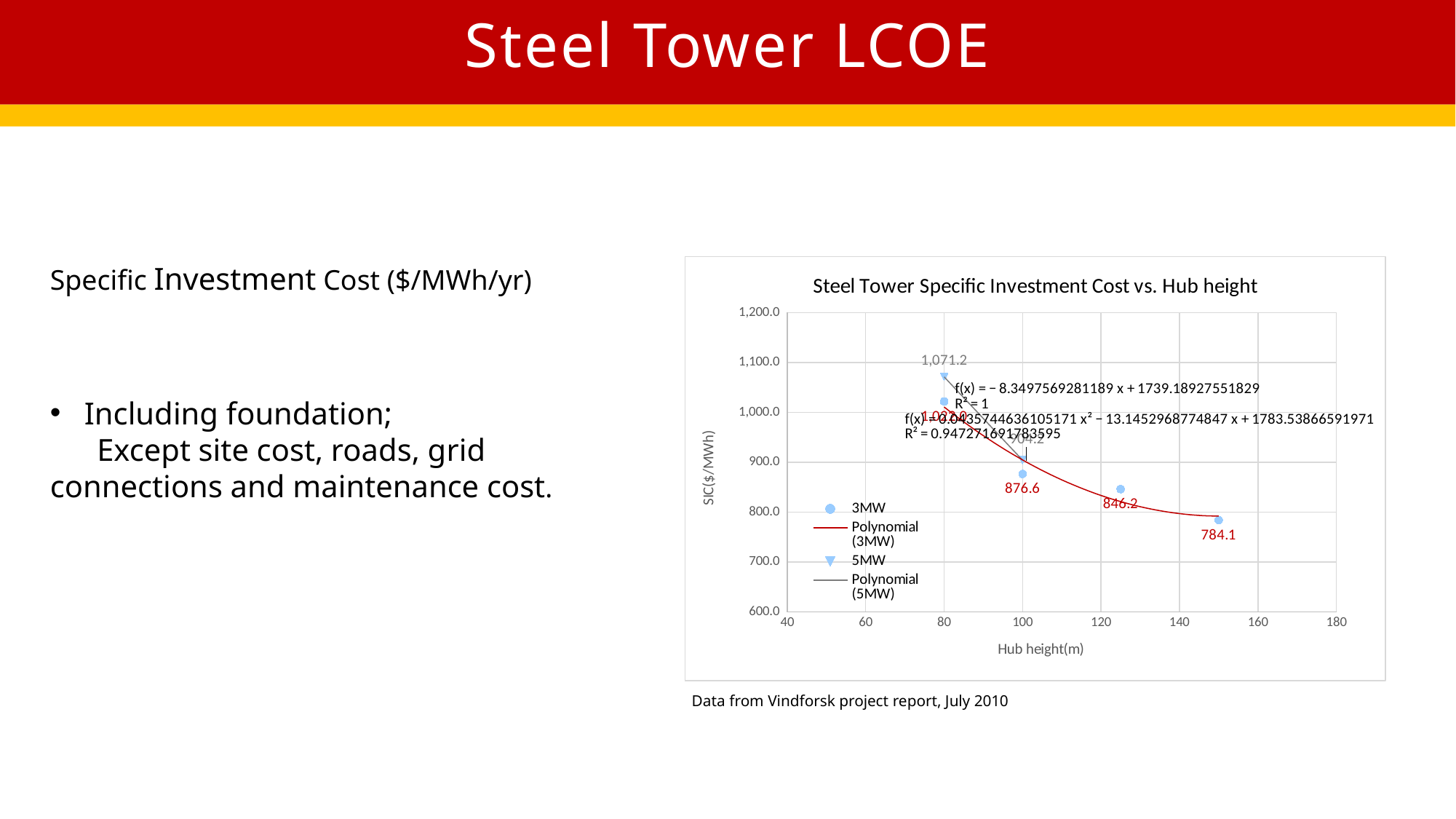
What is the 3MW specific investment cost at a hub height of 150 m? 784.1 Is the 5MW value at 100 m hub height greater or less than 1,000.0? less What kind of chart is shown on the slide? scatter chart How many entries does the chart legend list? 4 What is the 3MW specific investment cost at a hub height of 125 m? 846.2 What is the 3MW specific investment cost at a hub height of 100 m? 876.6 What is the difference between the 3MW values at 125 m and 150 m hub height? 62.1 Do the 3MW values rise or fall as hub height increases? fall What is the difference between the 3MW values at 100 m and 125 m hub height? 30.4 At which hub height is the 3MW specific investment cost lowest? 150 m Which is larger for the 3MW series: the value at 100 m or at 125 m hub height? 100 m What is the 5MW specific investment cost at a hub height of 80 m? 1,071.2